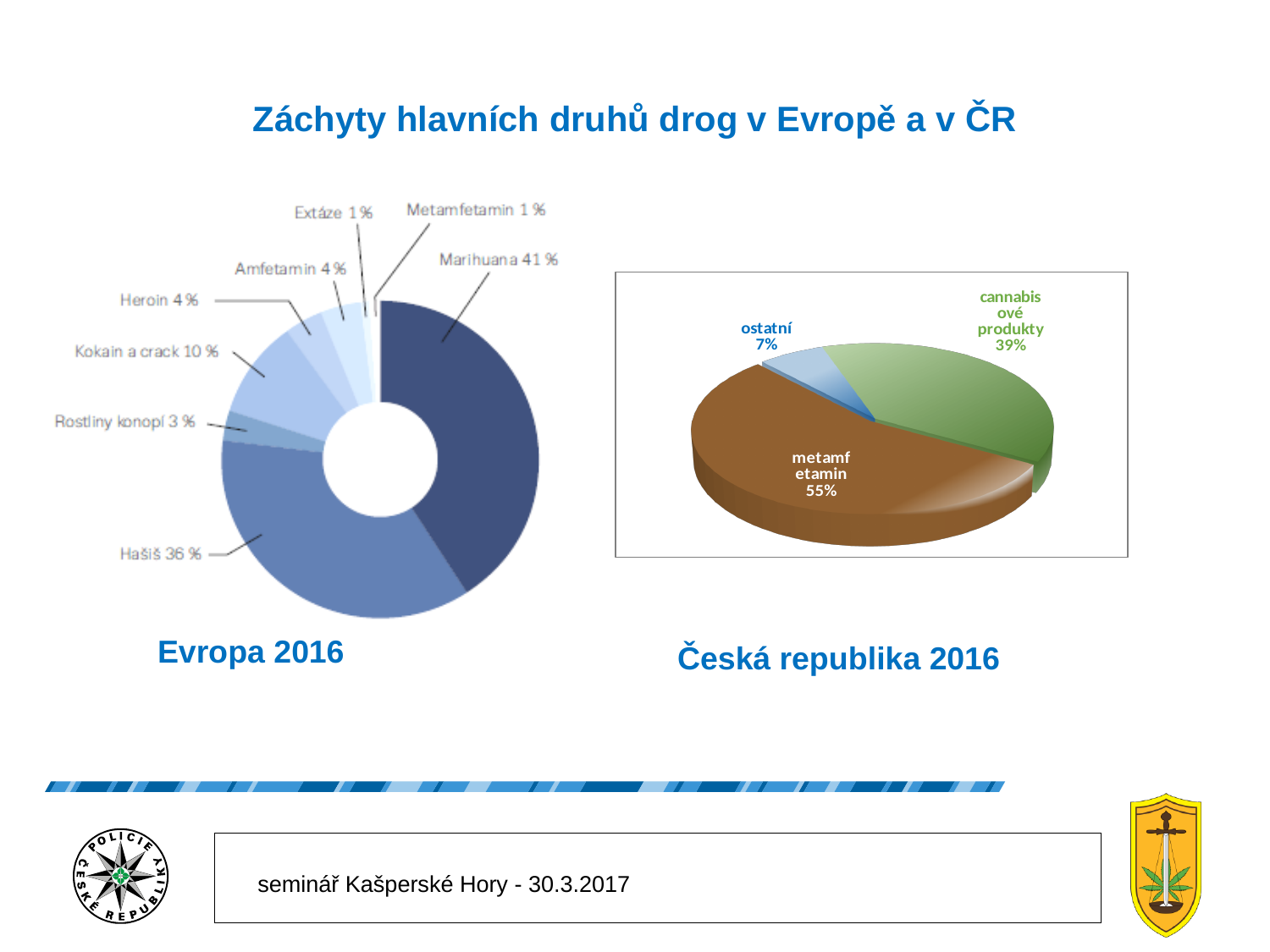
In the Evropa 2016 chart, what is the difference between the shares of Marihuana and Hašiš? 5 % In the Česká republika 2016 chart, which category has the smallest share? ostatní In the Evropa 2016 chart, how many categories are shown? 8 In the Evropa 2016 chart, what share does Kokain a crack have? 10 % In the Česká republika 2016 chart, how many slices are there? 3 In the Česká republika 2016 chart, what share does metamfetamin have? 55% In the Česká republika 2016 chart, what share do cannabisové produkty have? 39% In the Evropa 2016 chart, what share does Marihuana have? 41 % In the Evropa 2016 chart, what share does Hašiš have? 36 % What kind of chart is the Česká republika 2016 chart? Pie chart In the Evropa 2016 chart, which is larger, Heroin or Rostliny konopí? Heroin In the Evropa 2016 chart, which category has the largest share? Marihuana